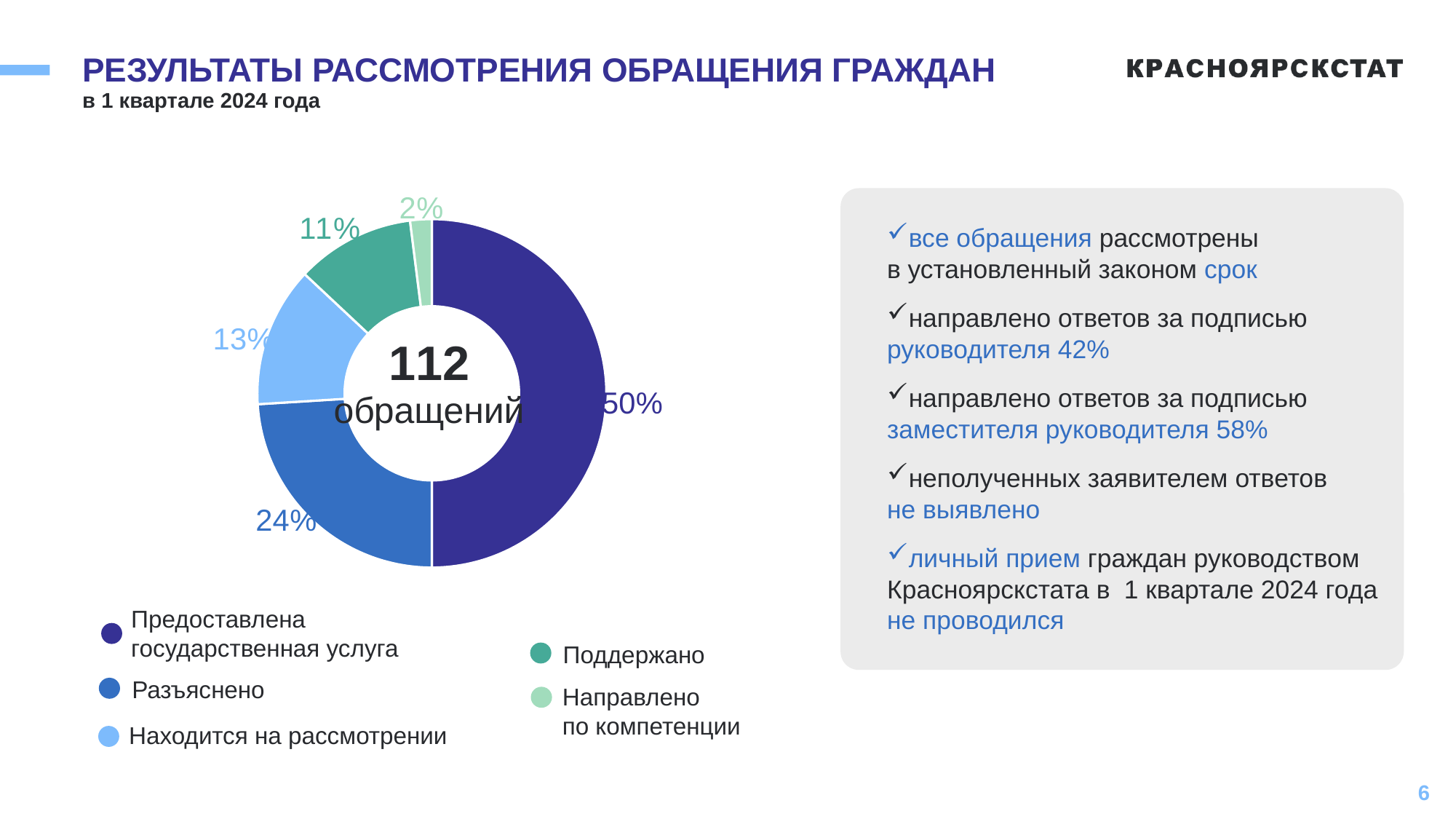
What share of the chart does "Разъяснено" account for? 24% What total number of appeals is shown in the centre of the chart? 112 Which category has the smallest share in the chart? Направлено по компетенции Which is larger: the share for "Находится на рассмотрении" or the share for "Поддержано"? Находится на рассмотрении What share of the chart does "Находится на рассмотрении" account for? 13% How many categories does the chart's legend list? 5 What is the difference in percentage points between "Предоставлена государственная услуга" and "Разъяснено"? 26 What share of the chart does "Направлено по компетенции" account for? 2% What kind of chart is shown on the slide? Donut (pie) chart Which category has the largest share in the chart? Предоставлена государственная услуга